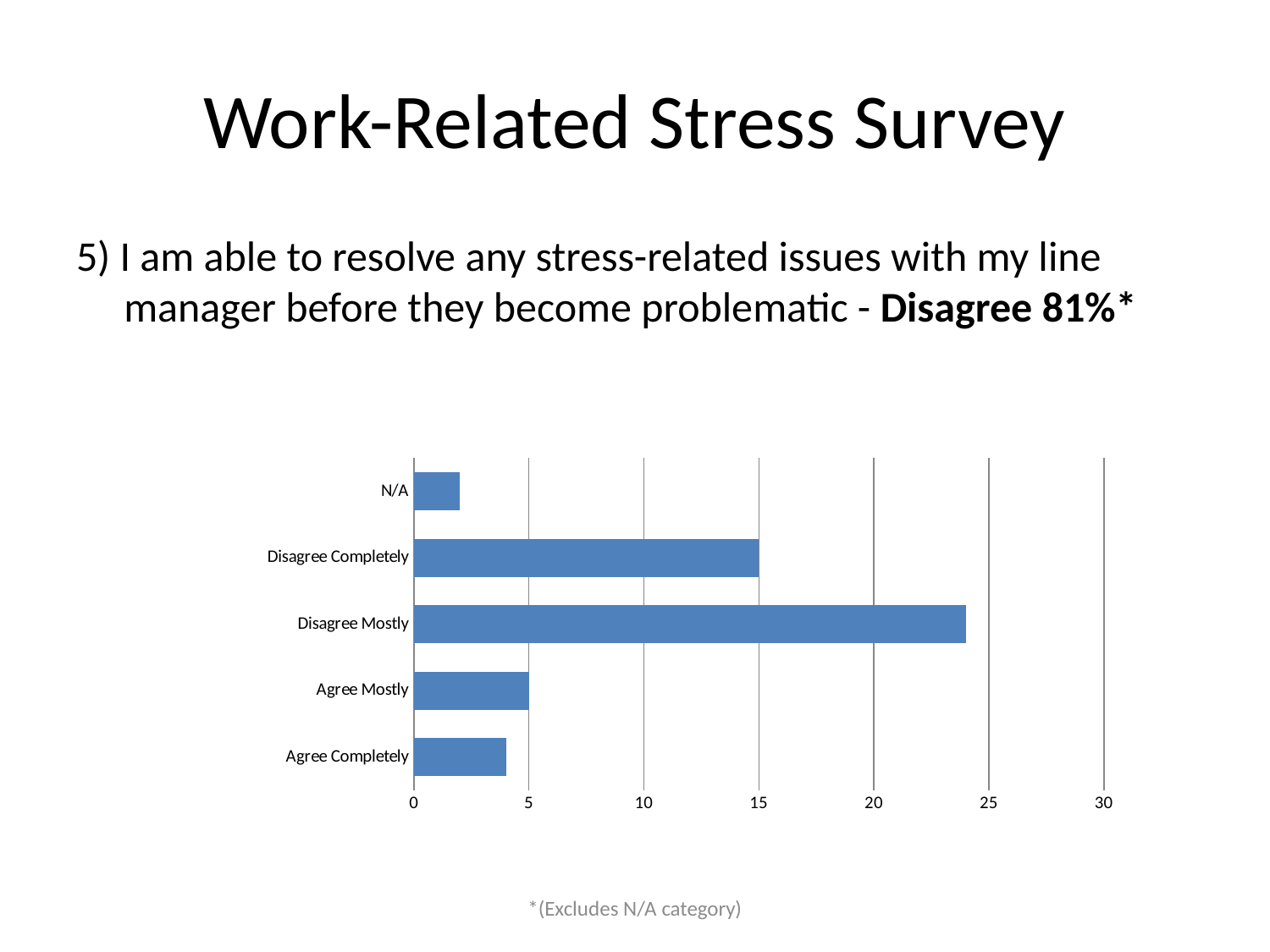
What type of chart is shown on the slide? bar chart Which category has the lowest value? N/A Is the value for N/A greater or less than 5? less What is the difference between the values for Disagree Completely and Agree Mostly? 10 How many categories are shown on the chart? 5 What is the highest value shown on the horizontal axis? 30 What is the value for Disagree Completely? 15 Which is larger, the value for Disagree Completely or the value for Agree Completely? Disagree Completely What is the value for Agree Mostly? 5 Is the value for Disagree Mostly greater or less than 20? greater Is the value for Agree Completely greater or less than 5? less Which category has the highest value? Disagree Mostly